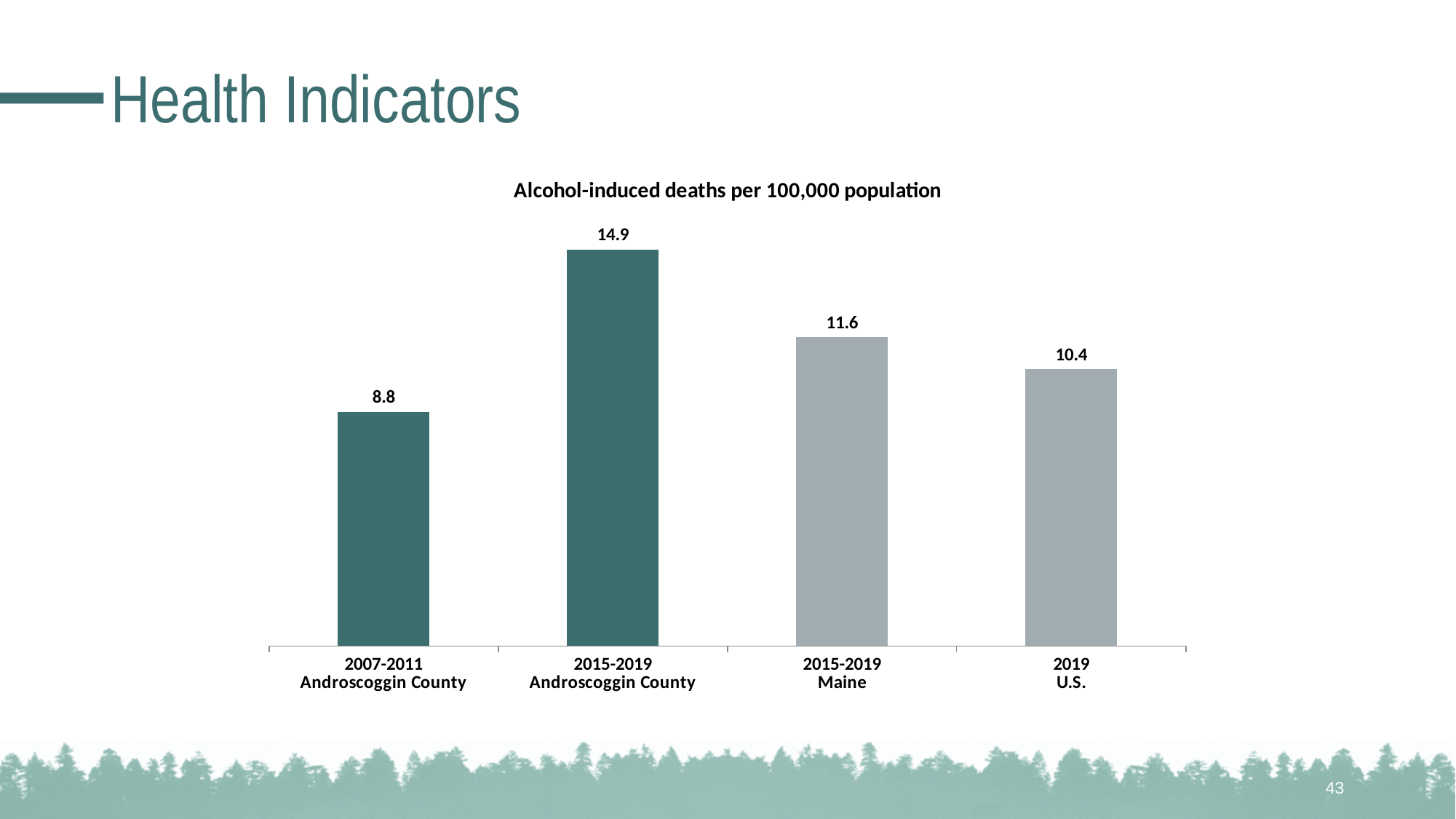
What is the difference between the 2015-2019 Maine value and the 2019 U.S. value? 1.2 What is the value for 2007-2011 Androscoggin County? 8.8 How many bars are shown in the chart? 4 Which category has the highest value? 2015-2019 Androscoggin County What kind of chart is shown on the slide? Bar chart What is the value for 2019 U.S.? 10.4 What is the value for 2015-2019 Androscoggin County? 14.9 What is the value for 2015-2019 Maine? 11.6 Which is larger, the value for 2015-2019 Maine or the value for 2019 U.S.? 2015-2019 Maine What is the title of the chart? Alcohol-induced deaths per 100,000 population What is the difference between the 2015-2019 Androscoggin County value and the 2007-2011 Androscoggin County value? 6.1 Which category has the lowest value? 2007-2011 Androscoggin County